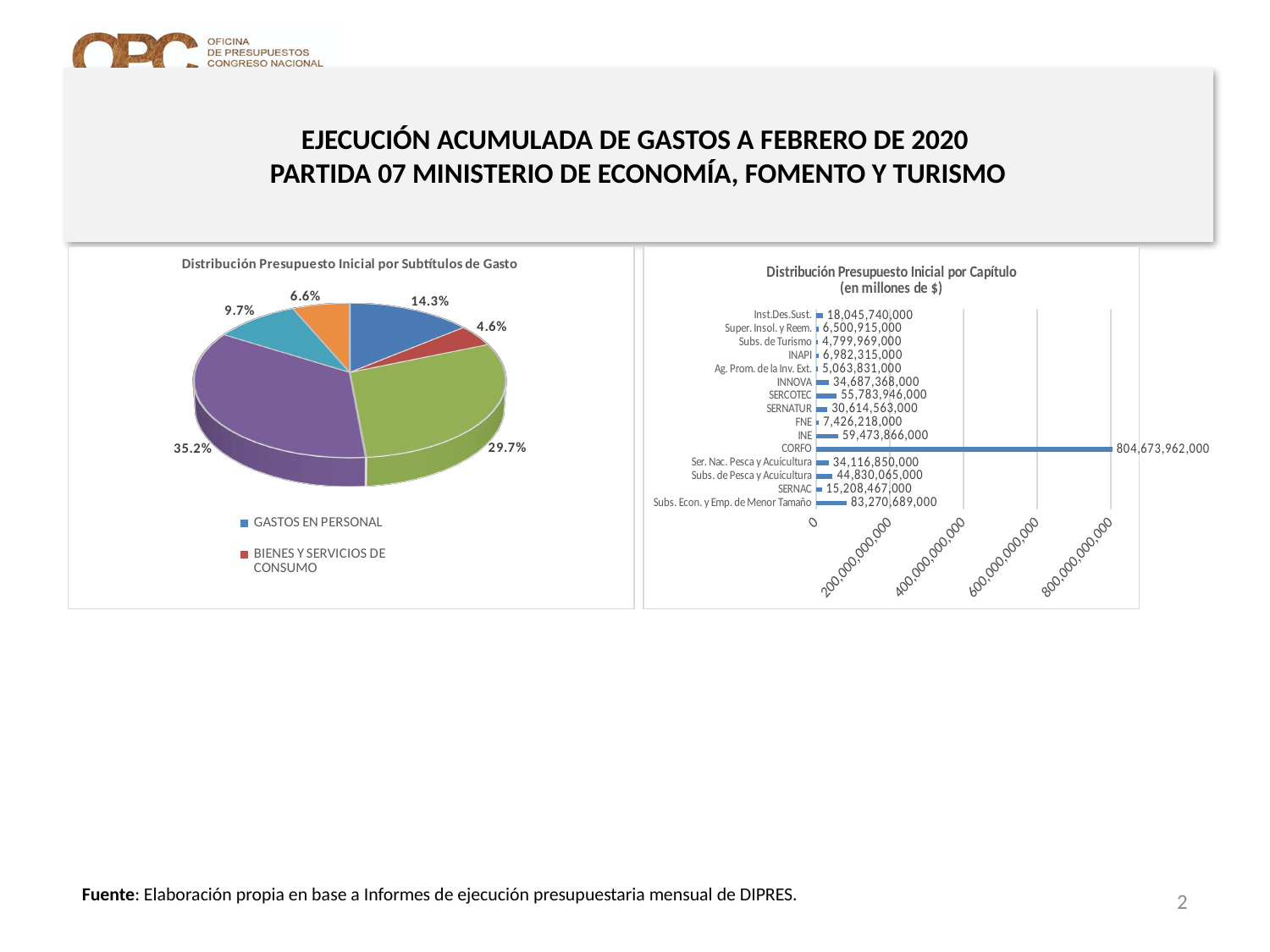
In the chart 'Distribución Presupuesto Inicial por Capítulo', what is the value for CORFO? 804,673,962,000 In the chart 'Distribución Presupuesto Inicial por Capítulo', what is the value for INE? 59,473,866,000 What kind of chart is 'Distribución Presupuesto Inicial por Subtítulos de Gasto'? Pie chart In the chart 'Distribución Presupuesto Inicial por Capítulo', which capítulo has the lowest value? Subs. de Turismo How many slices does the pie chart 'Distribución Presupuesto Inicial por Subtítulos de Gasto' have? 6 In the pie chart on the left, what is the largest percentage shown on any slice? 35.2% In the pie chart 'Distribución Presupuesto Inicial por Subtítulos de Gasto', what percentage is shown for GASTOS EN PERSONAL? 14.3% In the chart 'Distribución Presupuesto Inicial por Capítulo', which is larger, INNOVA or SERNATUR? INNOVA In the chart 'Distribución Presupuesto Inicial por Capítulo', which capítulo has the highest value? CORFO In the pie chart 'Distribución Presupuesto Inicial por Subtítulos de Gasto', what percentage is shown for BIENES Y SERVICIOS DE CONSUMO? 4.6% How many entries does the legend of the pie chart on the left list? 2 In the chart 'Distribución Presupuesto Inicial por Capítulo', what is the difference between the values for INE and SERCOTEC? 3,689,920,000